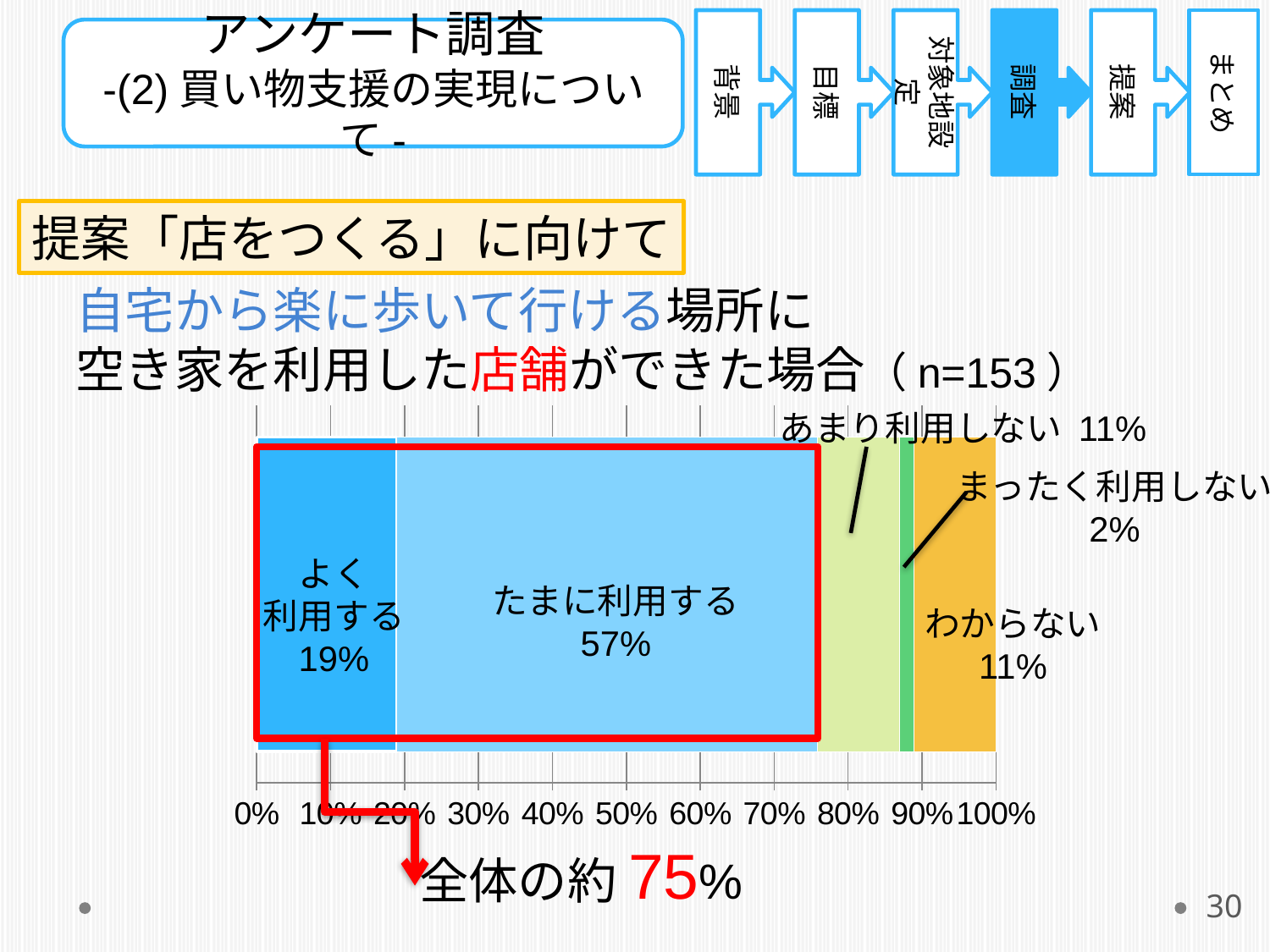
What percentage of respondents answered よく利用する? 19% What is the sample size (n) stated above the chart? n=153 What kind of chart is shown on the slide? Stacked bar chart What is the combined share of よく利用する and たまに利用する? 76% What is the difference between the shares for たまに利用する and よく利用する? 38% How many response categories are shown in the bar? 5 Which is larger, the share for よく利用する or the share for あまり利用しない? よく利用する What percentage of respondents answered まったく利用しない? 2% Which response category has the smallest share? まったく利用しない What percentage of respondents answered たまに利用する? 57% Which response category has the largest share? たまに利用する What percentage of respondents answered わからない? 11%